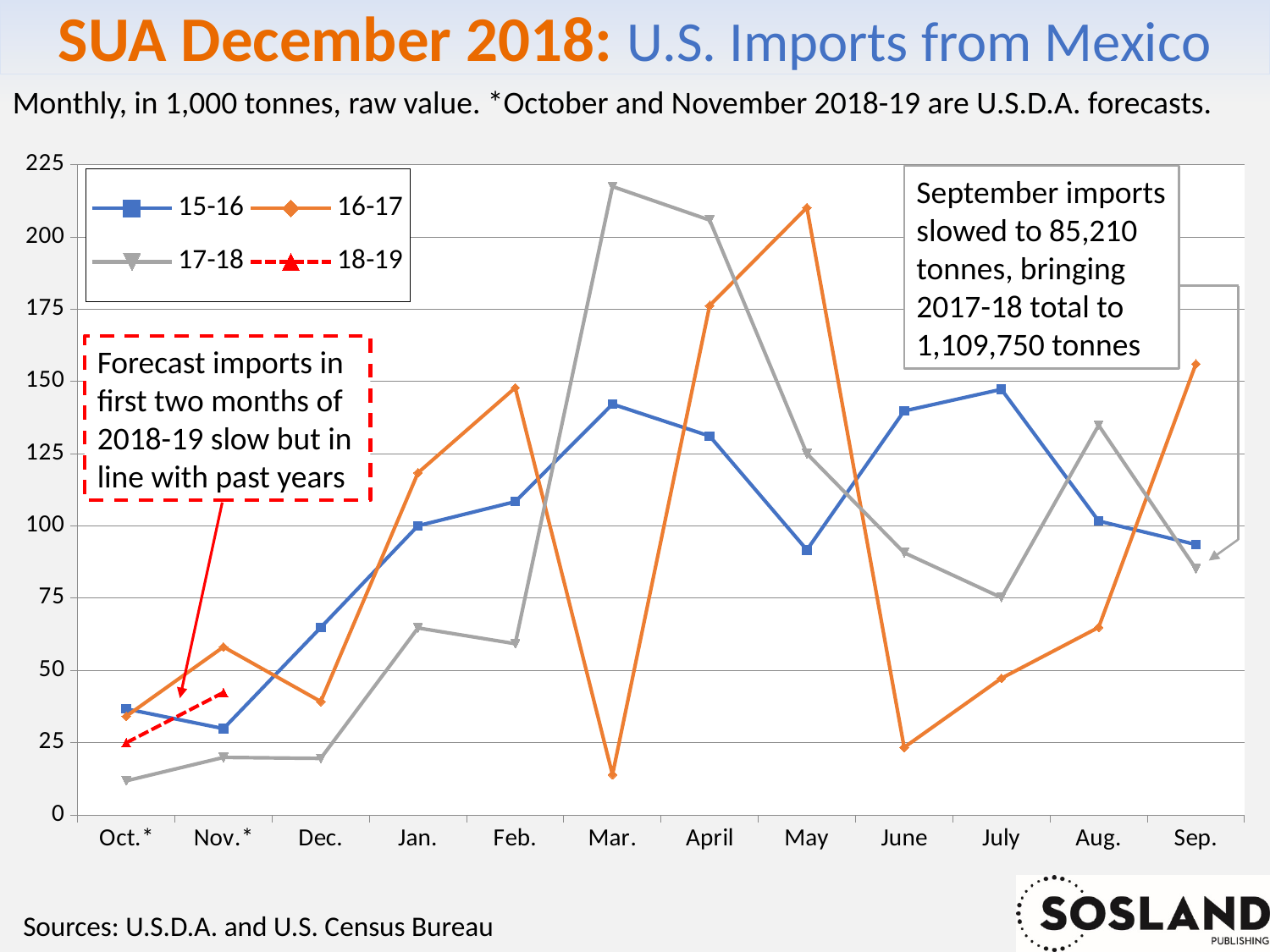
In which month does the 16-17 series reach its lowest value? Mar. What kind of chart is shown on the slide? line chart Is the value for 16-17 in Mar. greater or less than 25? less How many months are shown along the x axis? 12 Is the value for 17-18 in Mar. greater or less than 200? greater How many series does the legend list? 4 In which month does the 16-17 series reach its highest value? May In May, which series has the larger value, 16-17 or 15-16? 16-17 Is the value for 15-16 in July greater or less than 125? greater Does the 15-16 series rise or fall from Oct.* to Mar.? rise In which month does the 17-18 series reach its highest value? Mar. Which series is drawn as a dashed red line? 18-19